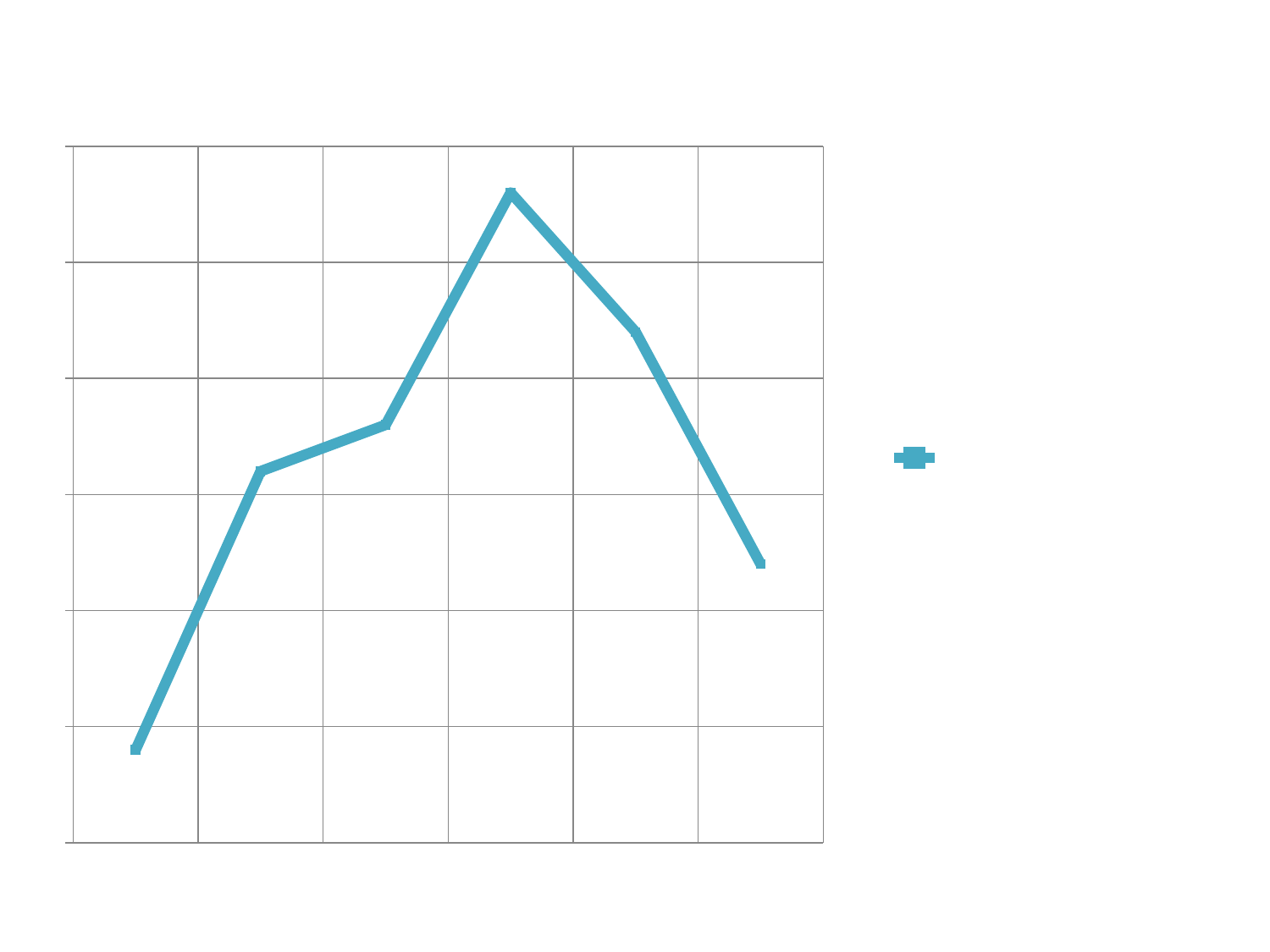
Which is larger, the value of the second point from the left or the value of the last point? the second point How many data points are plotted on the line? 6 Do the values rise or fall from the first point to the fourth point along the x axis? rise Which is larger, the value of the fifth point from the left or the value of the third point? the fifth point Which data point, counting from the left, has the highest value? the fourth point What colour is the plotted line? blue Do the values rise or fall from the fourth point to the last point along the x axis? fall What kind of chart is shown on the slide? line chart How many series does the legend list? 1 Which data point, counting from the left, has the lowest value? the first point